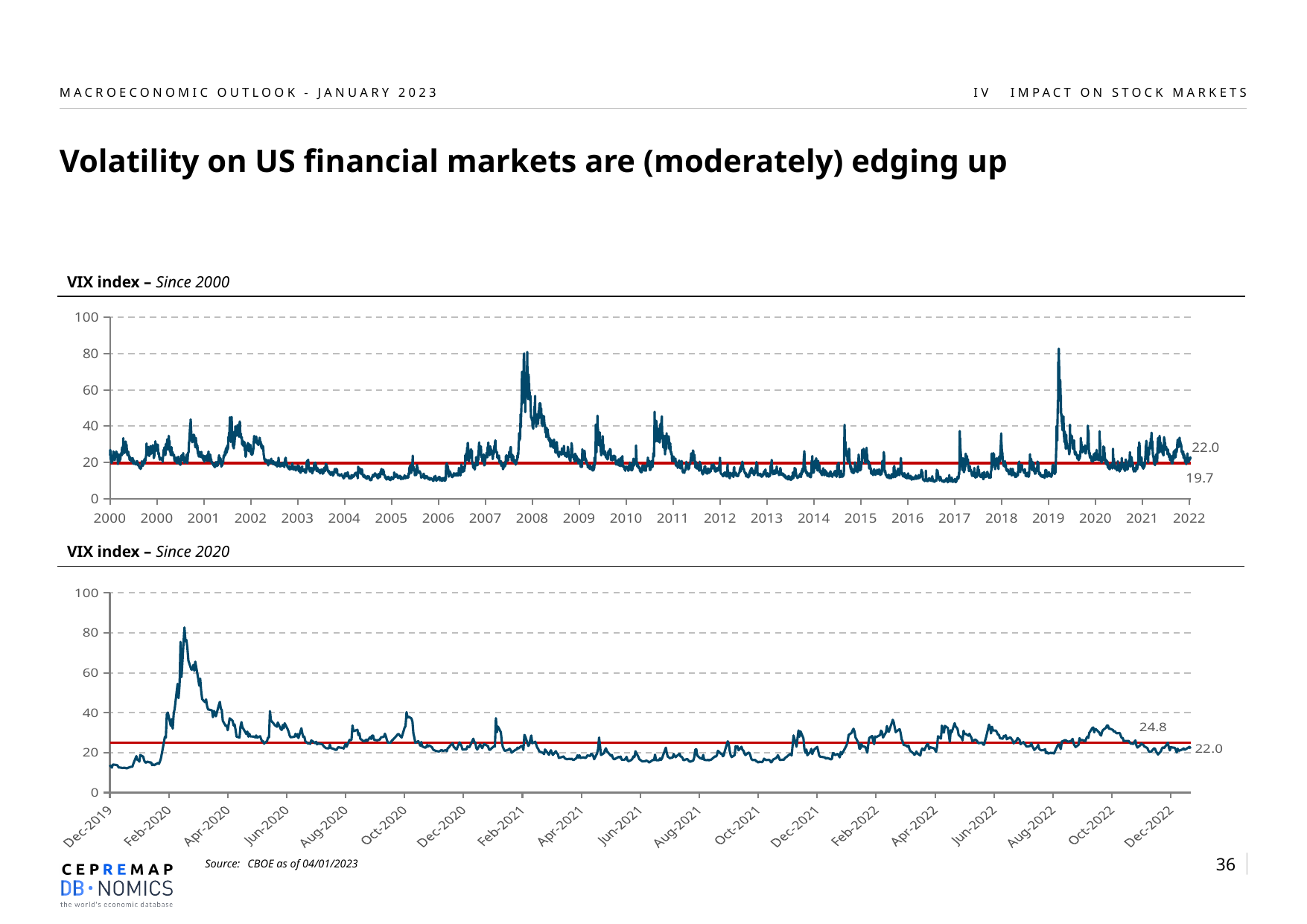
What kind of chart is the 'VIX index – Since 2000' chart? line chart In the 'VIX index – Since 2020' chart, what is the latest value labelled at the right end of the line? 22.0 In the 'VIX index – Since 2020' chart, what is the difference between the red line value (24.8) and the latest value (22.0)? 2.8 In the 'VIX index – Since 2000' chart, what value is labelled for the red horizontal line? 19.7 In the 'VIX index – Since 2000' chart, which is larger: the latest value or the red line value? the latest value (22.0) In the 'VIX index – Since 2000' chart, is the peak value reached around 2008 greater or less than 60? greater In the 'VIX index – Since 2020' chart, which is larger: the red line value or the latest value? the red line value (24.8) In the 'VIX index – Since 2020' chart, what value is labelled for the red horizontal line? 24.8 What source is cited for the charts on the slide? CBOE as of 04/01/2023 In the 'VIX index – Since 2000' chart, what is the difference between the latest value (22.0) and the red line value (19.7)? 2.3 In the 'VIX index – Since 2020' chart, is the peak value reached around Mar-2020 greater or less than 60? greater In the 'VIX index – Since 2000' chart, what is the latest value labelled at the right end of the line? 22.0